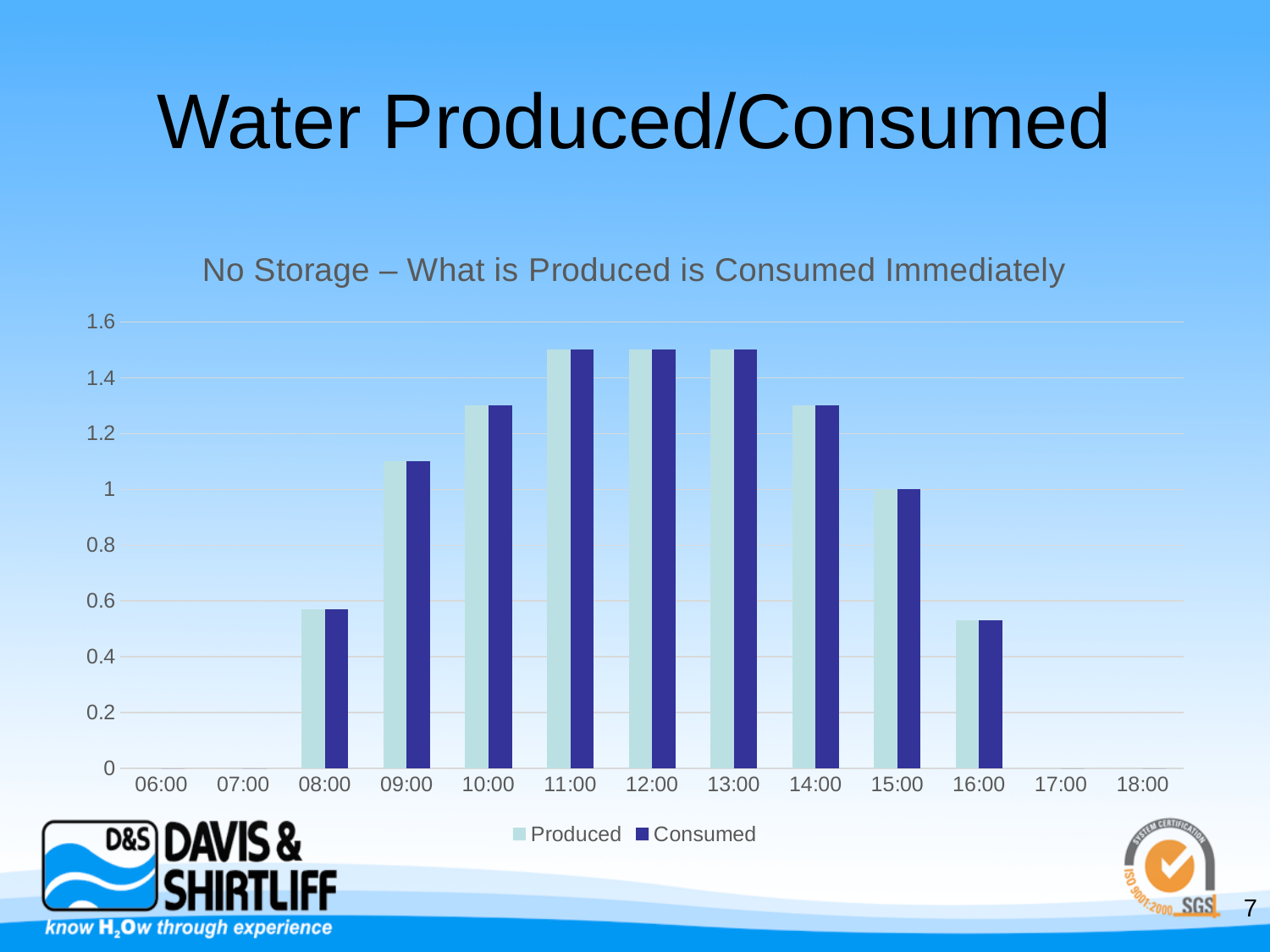
What is the title of the chart? No Storage – What is Produced is Consumed Immediately Is the Produced value at 11:00 greater or less than 1.4? greater Which is larger, the Consumed value at 09:00 or the Consumed value at 14:00? 14:00 What are the two series named in the chart legend? Produced and Consumed Is the Consumed value at 08:00 greater or less than 0.6? less What kind of chart is shown on the slide? bar chart Do the Consumed values rise or fall from 13:00 to 16:00? fall How many series does the chart legend list? 2 Is the Consumed value at 16:00 greater or less than 0.6? less How many time categories are shown on the x axis? 13 Do the Produced values rise or fall from 08:00 to 11:00? rise